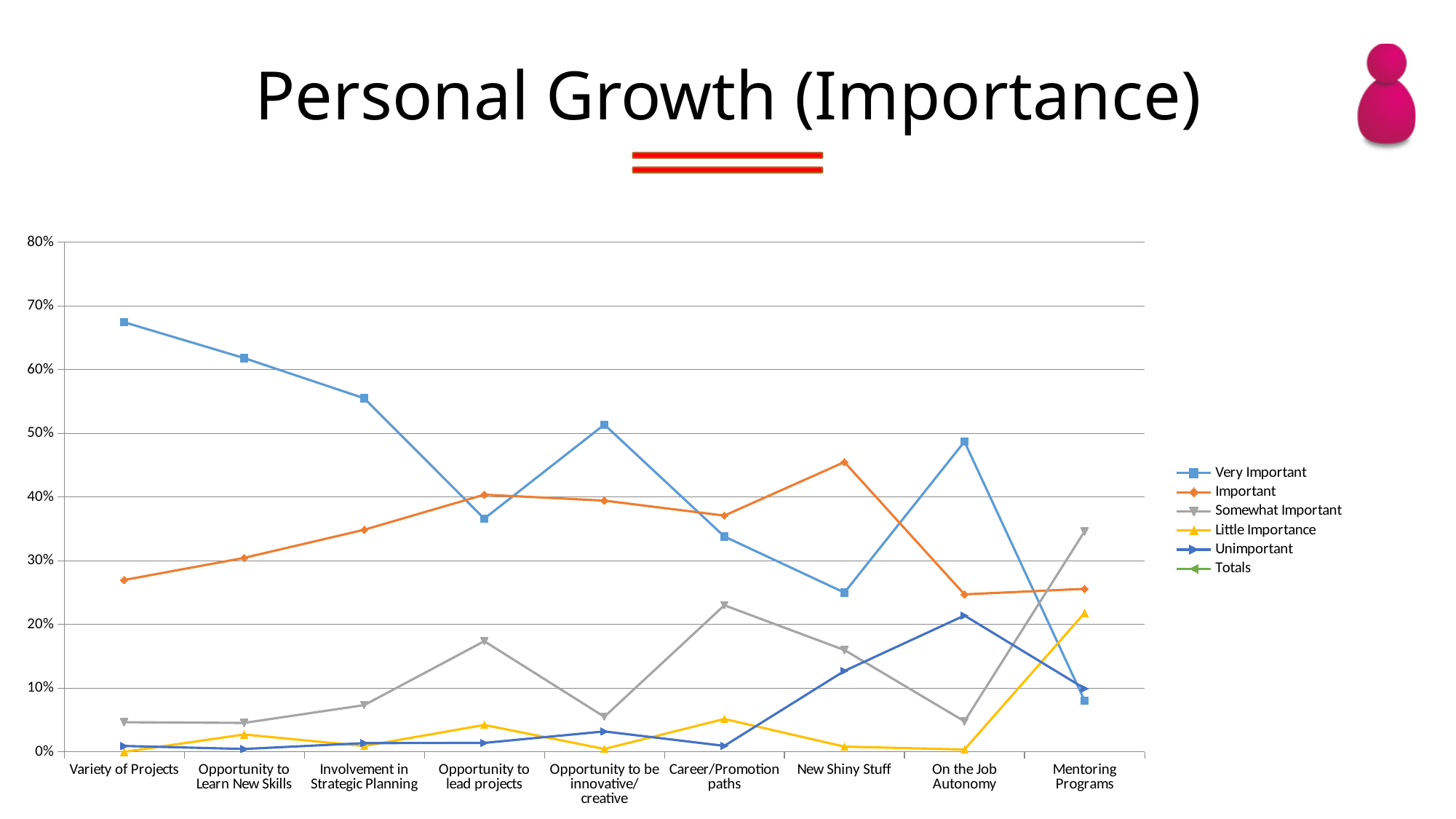
For New Shiny Stuff, which is larger: the Very Important value or the Important value? Important How many series does the legend list? 6 For which category is the Important series highest? New Shiny Stuff Is the Very Important value for Variety of Projects greater or less than 60%? greater For which category is the Very Important series highest? Variety of Projects How many categories are shown along the x axis? 9 For which category is the Somewhat Important series highest? Mentoring Programs Does the Very Important series rise or fall from Variety of Projects to Opportunity to lead projects? fall Is the Important value for New Shiny Stuff greater or less than 40%? greater For which category is the Very Important series lowest? Mentoring Programs What kind of chart is shown on the slide? line chart What is the title of the slide containing the chart? Personal Growth (Importance)